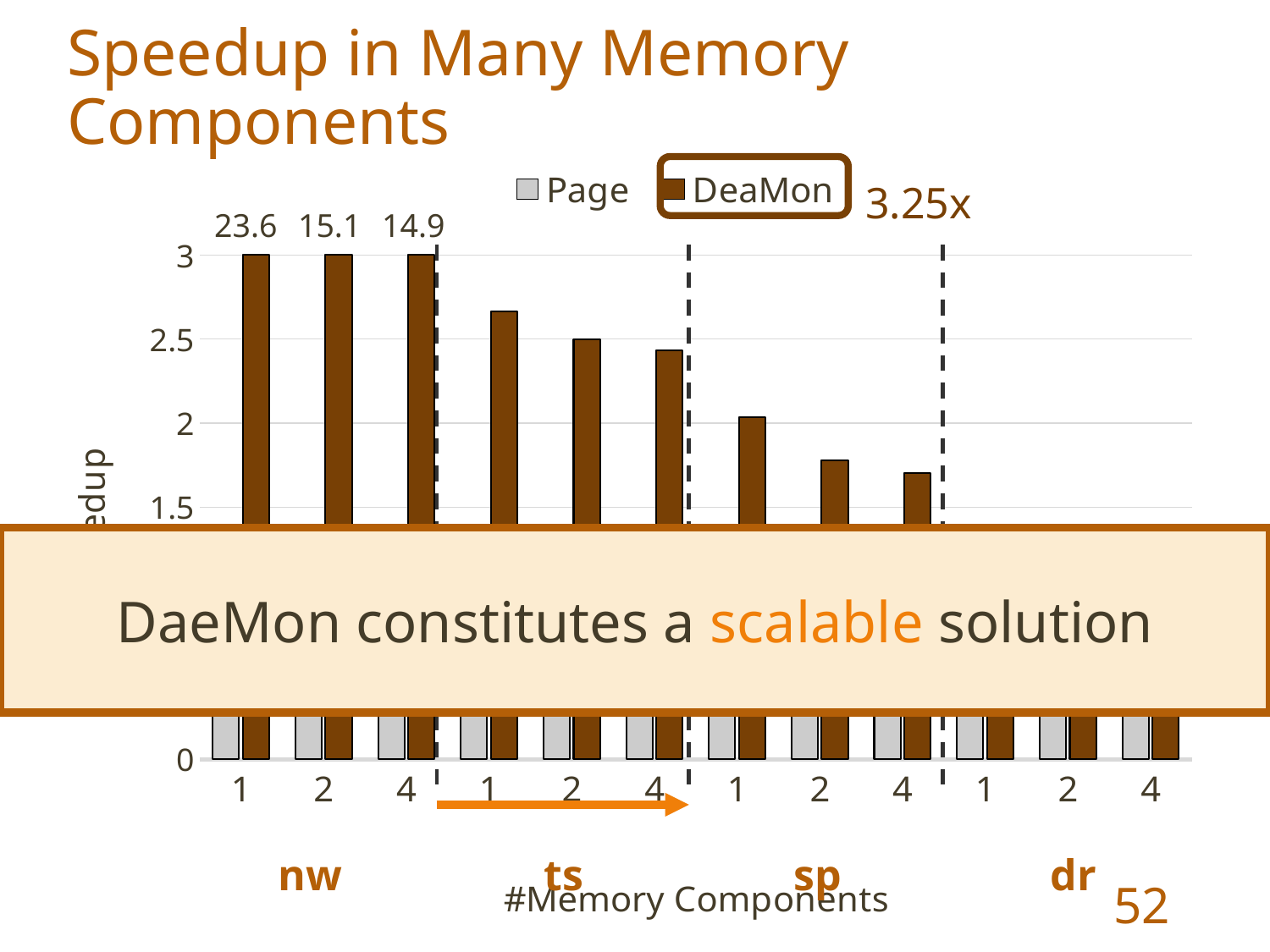
What is the difference between the labelled DeaMon speedups for nw with 1 and with 2 memory components? 8.5 Among the three labelled nw bars, which number of memory components has the highest DeaMon speedup? 1 Is the DeaMon speedup for ts with 1 memory component greater or less than 2.5? greater Within the ts group, does the DeaMon speedup rise or fall as the number of memory components increases from 1 to 4? fall What is the DeaMon speedup value labelled for nw with 4 memory components? 14.9 How many workload groups (nw, ts, sp, dr) are shown along the x axis? 4 Is the DeaMon speedup for sp with 2 memory components greater or less than 2? less What are the two series named in the legend? Page and DeaMon What is the DeaMon speedup value labelled for nw with 2 memory components? 15.1 What kind of chart is shown on the slide? bar chart How many series does the legend list? 2 What is the DeaMon speedup value labelled for nw with 1 memory component? 23.6